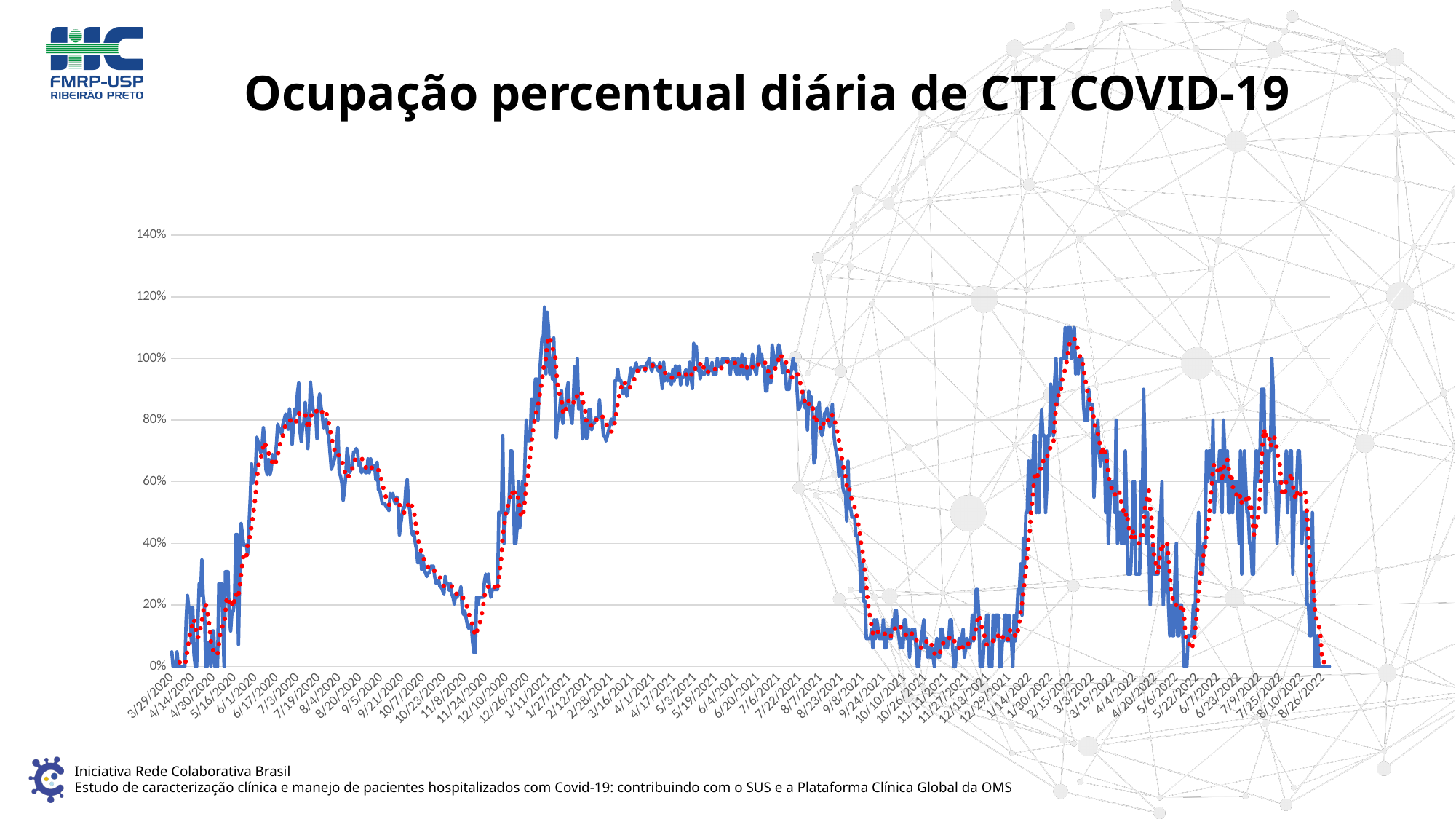
Is the peak value around 1/11/2021 greater or less than 100%? greater Is the value at the end of the series, around 8/26/2022, greater or less than 20%? less What is the title of the chart? Ocupação percentual diária de CTI COVID-19 Between 12/29/2021 and 2/15/2022, do the values rise or fall? rise Is the value around 5/19/2021 greater or less than 80%? greater Between 8/23/2021 and 9/24/2021, do the values rise or fall? fall Is the value around 5/19/2021 larger or smaller than the value around 10/26/2021? larger What kind of chart is shown on the slide? line chart What is the highest value shown on the vertical axis of the chart? 140%